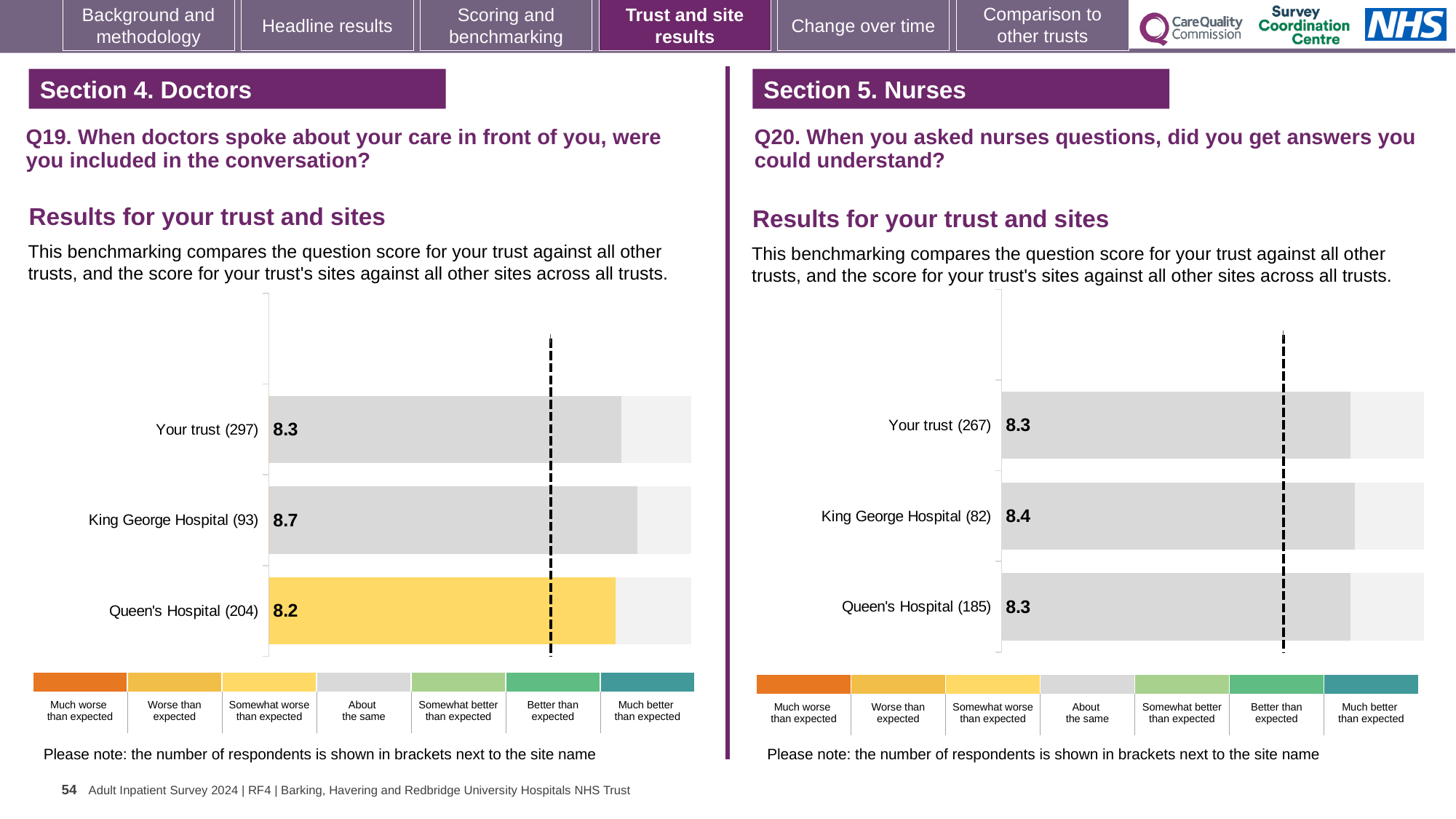
In the Q19 chart (Section 4. Doctors), which site or trust row has the highest score? King George Hospital In the Q19 chart (Section 4. Doctors), what is the score for Your trust? 8.3 In the Q19 chart (Section 4. Doctors), which benchmark category does the colour of the Queen's Hospital bar correspond to? Somewhat worse than expected In the Q20 chart (Section 5. Nurses), what is the score for King George Hospital? 8.4 In the Q20 chart (Section 5. Nurses), which has the higher score, King George Hospital or Queen's Hospital? King George Hospital In the Q20 chart (Section 5. Nurses), what is the score for Queen's Hospital? 8.3 How many rows (trust and sites) are plotted in the Q20 chart (Section 5. Nurses)? 3 In the Q19 chart (Section 4. Doctors), what is the score for Queen's Hospital? 8.2 In the Q19 chart (Section 4. Doctors), what is the score for King George Hospital? 8.7 What kind of chart is used in the Q19 chart (Section 4. Doctors)? Bar chart In the Q19 chart (Section 4. Doctors), which site or trust row has the lowest score? Queen's Hospital In the Q19 chart (Section 4. Doctors), what is the difference between the King George Hospital score and the Queen's Hospital score? 0.5